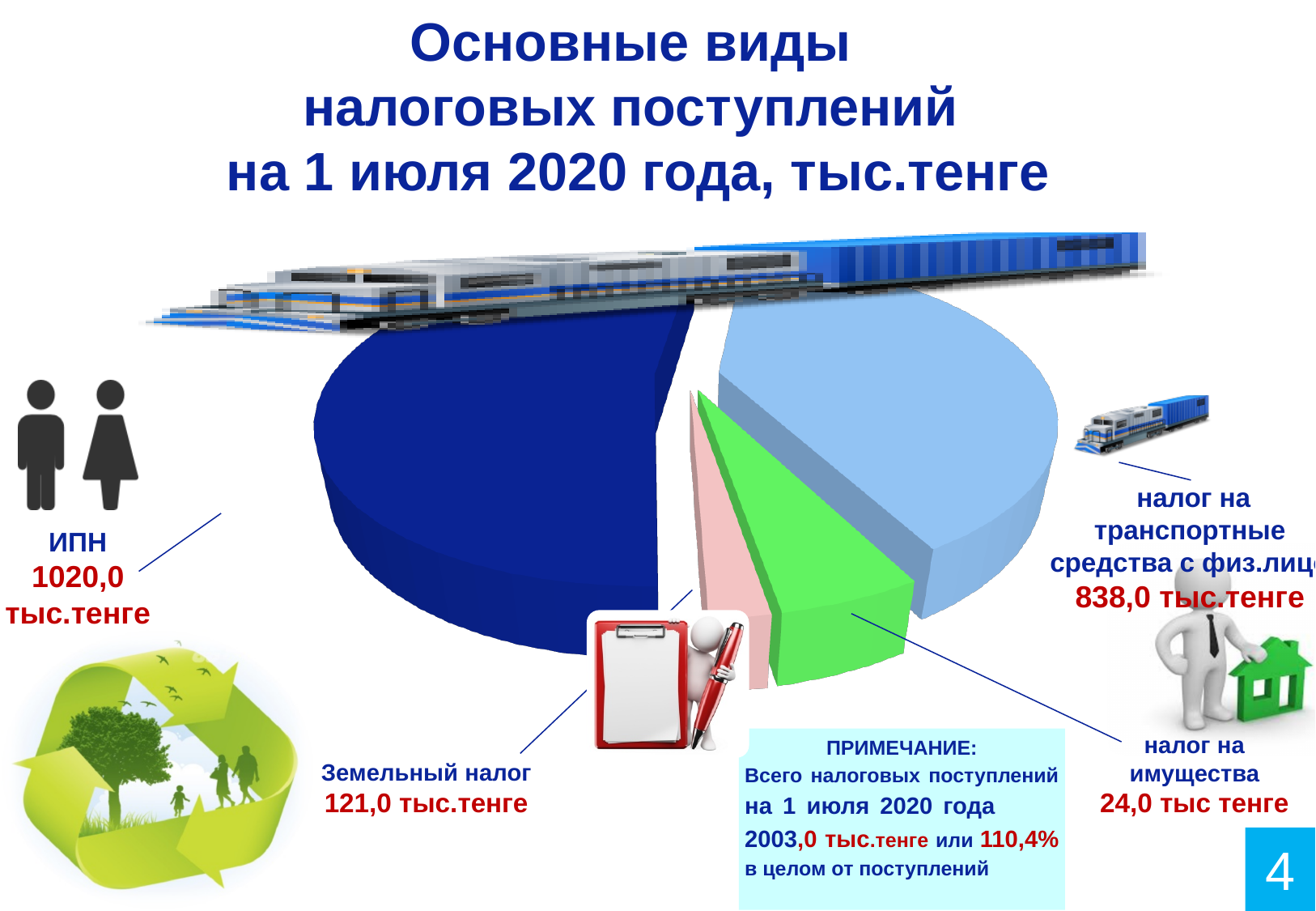
Which type of tax revenue has the highest value? ИПН Which type of tax revenue has the lowest value? налог на имущества What is the value for налог на имущества? 24,0 тыс тенге What is the difference between Земельный налог and налог на имущества? 97,0 тыс.тенге What kind of chart is shown on the slide? pie chart What is the value for Земельный налог? 121,0 тыс.тенге What is the difference between ИПН and налог на транспортные средства с физ.лиц? 182,0 тыс.тенге What is the value for ИПН? 1020,0 тыс.тенге What is the total of all tax revenues as of 1 July 2020 according to the note? 2003,0 тыс.тенге What is the value for налог на транспортные средства с физ.лиц? 838,0 тыс.тенге How many categories of tax revenue are shown in the pie chart? 4 Which is larger, Земельный налог or налог на имущества? Земельный налог